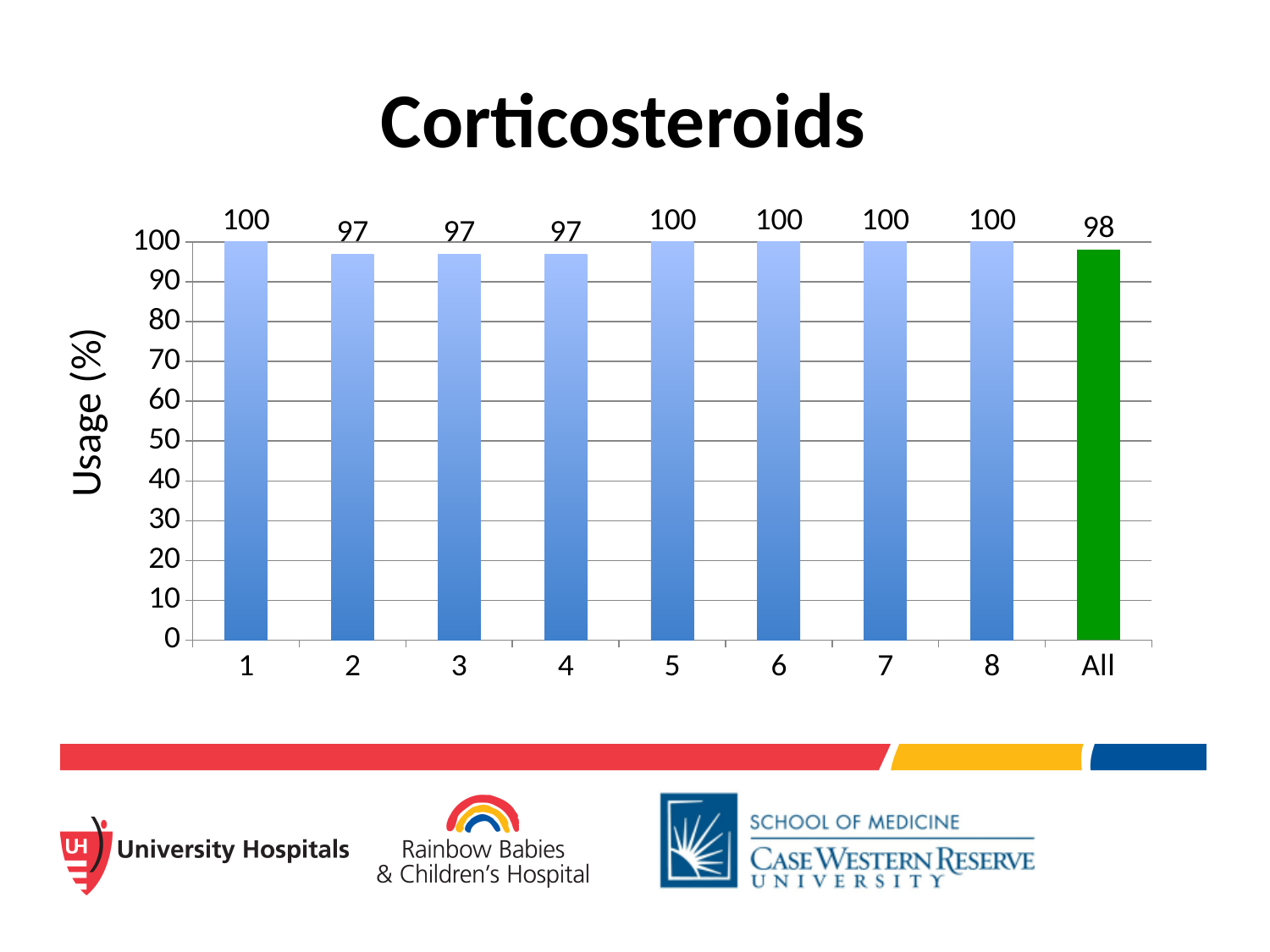
What is the label of the y axis? Usage (%) What is the usage (%) for category 5? 100 What type of chart is shown? Bar chart What is the title of the chart? Corticosteroids What is the difference in usage (%) between 'All' and category 4? 1 How many categories are shown on the x axis? 9 What is the usage (%) for the 'All' category? 98 What is the difference in usage (%) between category 1 and category 3? 3 Which has a higher usage (%), category 6 or category 2? Category 6 What is the usage (%) for category 2? 97 Which categories have the lowest usage (%)? 2, 3 and 4 How many categories have a usage of 100%? 5